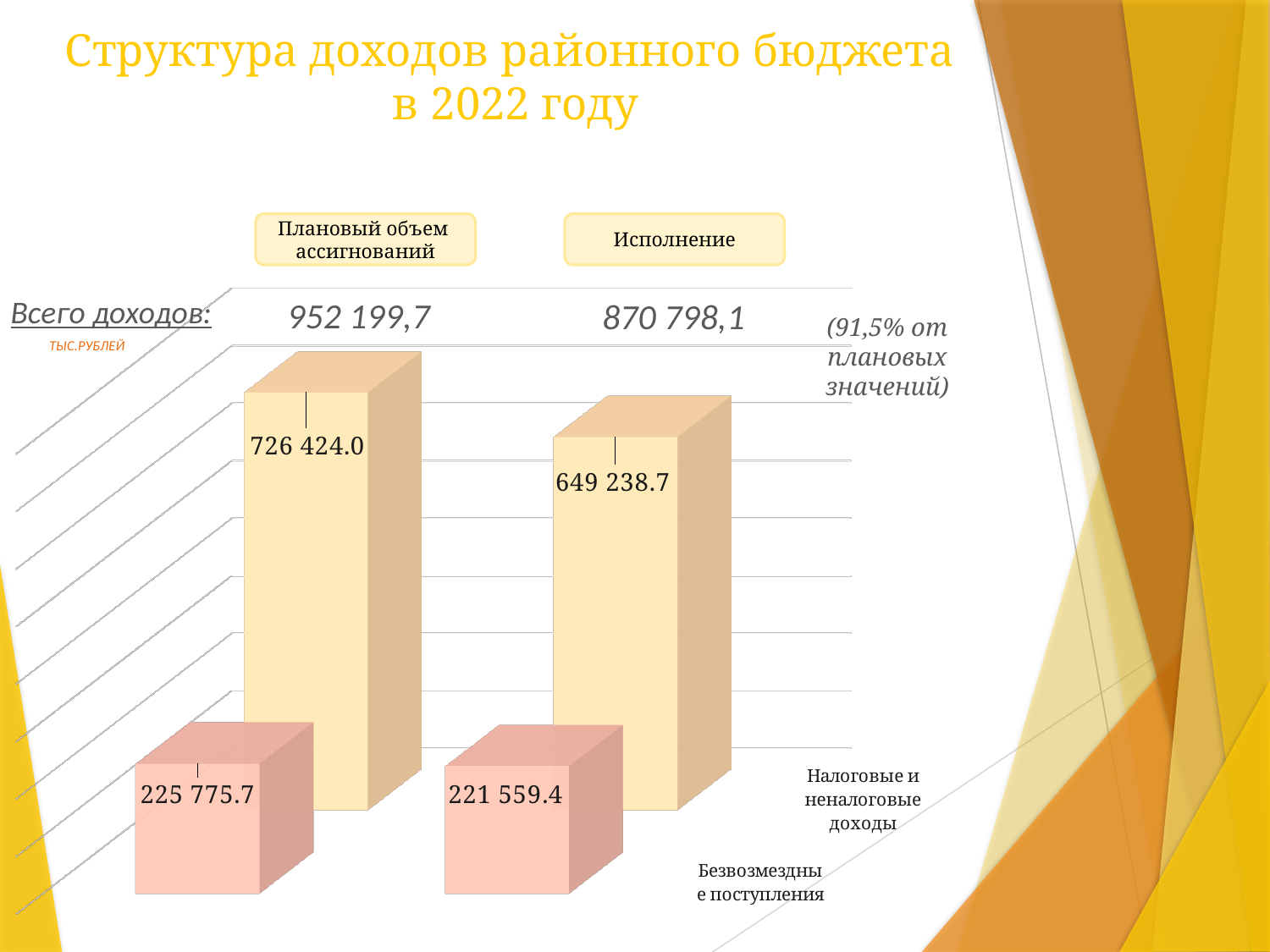
What is the difference between the pink bar values for Плановый объем ассигнований and Исполнение? 4 216.3 What is the value of the tall yellow bar for Исполнение? 649 238.7 How many categories are shown along the x axis of the chart? 2 What is the value of the pink bar for Исполнение? 221 559.4 Which bar has the highest value on the chart? the yellow bar for Плановый объем ассигнований (726 424.0) What is the value of the pink bar for Плановый объем ассигнований? 225 775.7 What is the difference between the yellow bar values for Плановый объем ассигнований and Исполнение? 77 185.3 What is the value of the tall yellow bar for Плановый объем ассигнований? 726 424.0 Do the bar values rise or fall from Плановый объем ассигнований to Исполнение? fall How many data series does the chart plot? 2 Which bar is larger for Исполнение, the yellow bar or the pink bar? the yellow bar What kind of chart is shown on the slide? bar chart